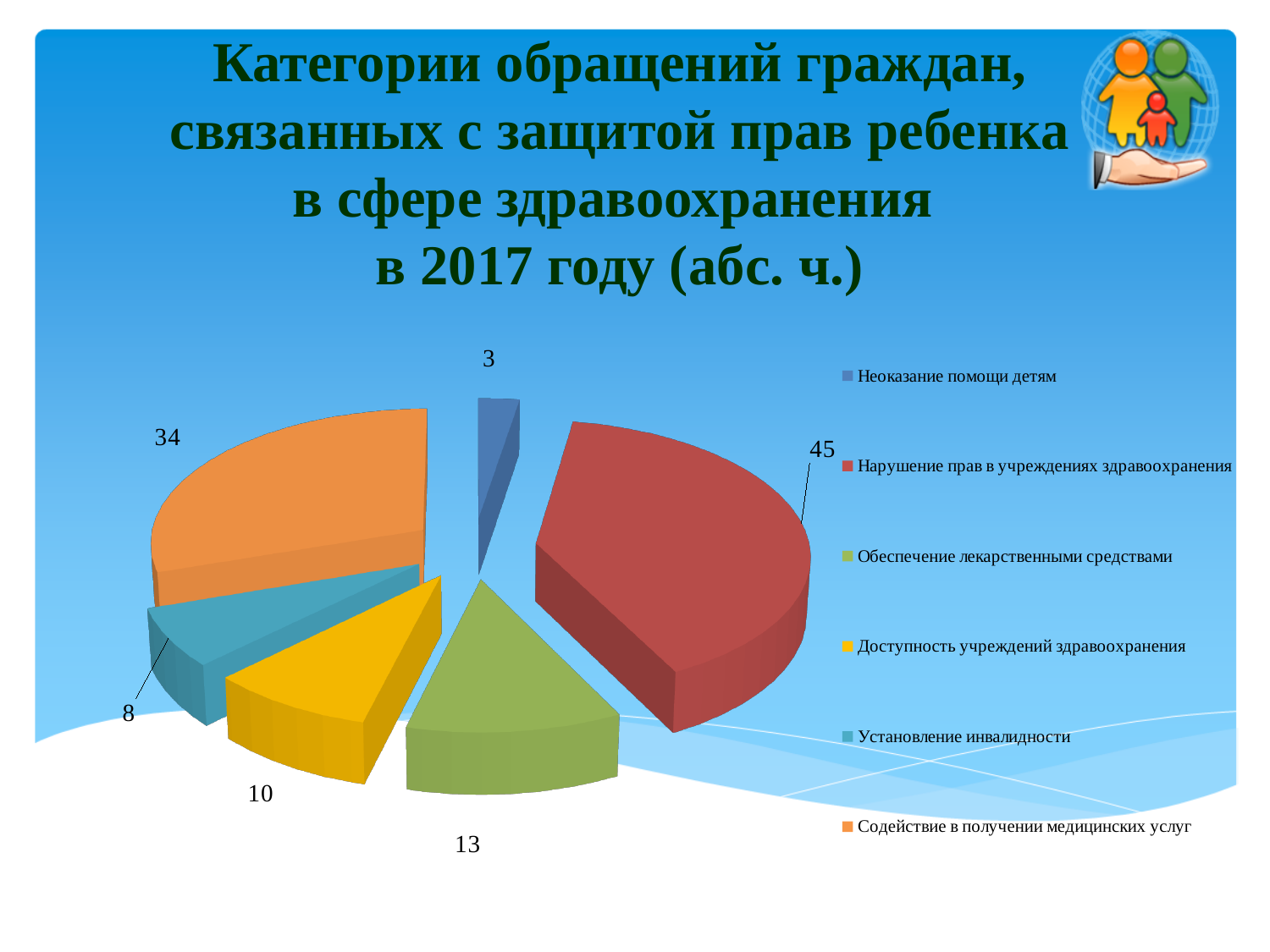
What is the value for "Нарушение прав в учреждениях здравоохранения"? 45 What is the value for "Установление инвалидности"? 8 What is the total of all the values in the pie chart? 113 Which is larger: "Доступность учреждений здравоохранения" or "Обеспечение лекарственными средствами"? Обеспечение лекарственными средствами Which category has the largest value? Нарушение прав в учреждениях здравоохранения What is the value for "Обеспечение лекарственными средствами"? 13 What colour is the slice for "Доступность учреждений здравоохранения"? Yellow What is the difference between the values for "Нарушение прав в учреждениях здравоохранения" and "Содействие в получении медицинских услуг"? 11 Which category has the smallest value? Неоказание помощи детям What is the value for "Содействие в получении медицинских услуг"? 34 What type of chart is shown on the slide? Pie chart How many categories does the pie chart have? 6